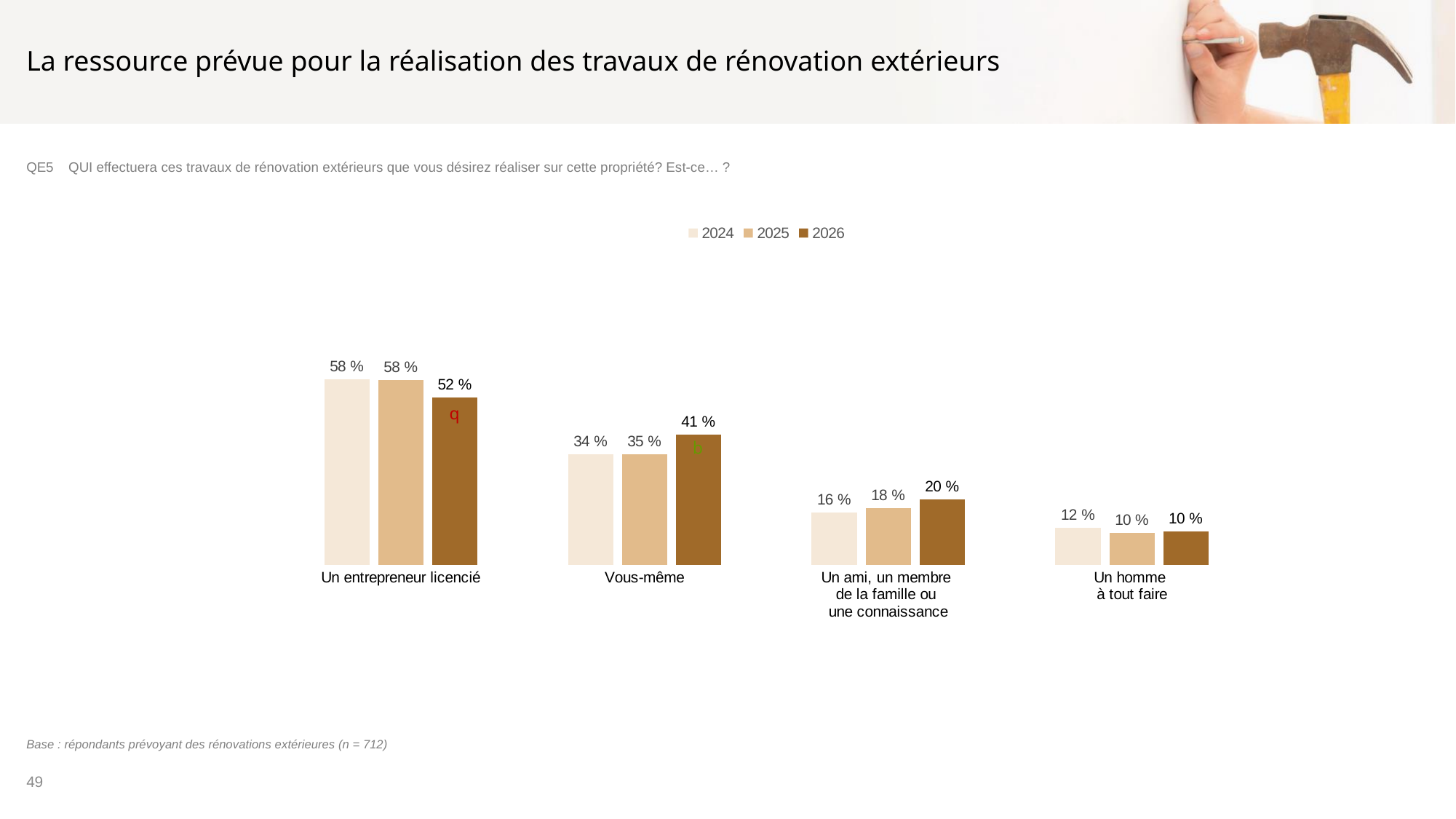
Which category has the highest value for 2026? Un entrepreneur licencié Which category has the lowest value for 2025? Un homme à tout faire Which is larger for "Vous-même": the 2025 value or the 2026 value? 2026 What is the value for 2026 for "Un entrepreneur licencié"? 52 % What kind of chart is shown on the slide? Bar chart What is the value for 2024 for "Un homme à tout faire"? 12 % What is the difference between the 2024 and 2026 values for "Un entrepreneur licencié"? 6 % How many categories are shown on the x axis? 4 How many series does the legend list? 3 What is the value for 2025 for "Un ami, un membre de la famille ou une connaissance"? 18 % What is the value for 2024 for "Vous-même"? 34 % Do the values for "Un ami, un membre de la famille ou une connaissance" rise or fall from 2024 to 2026? Rise